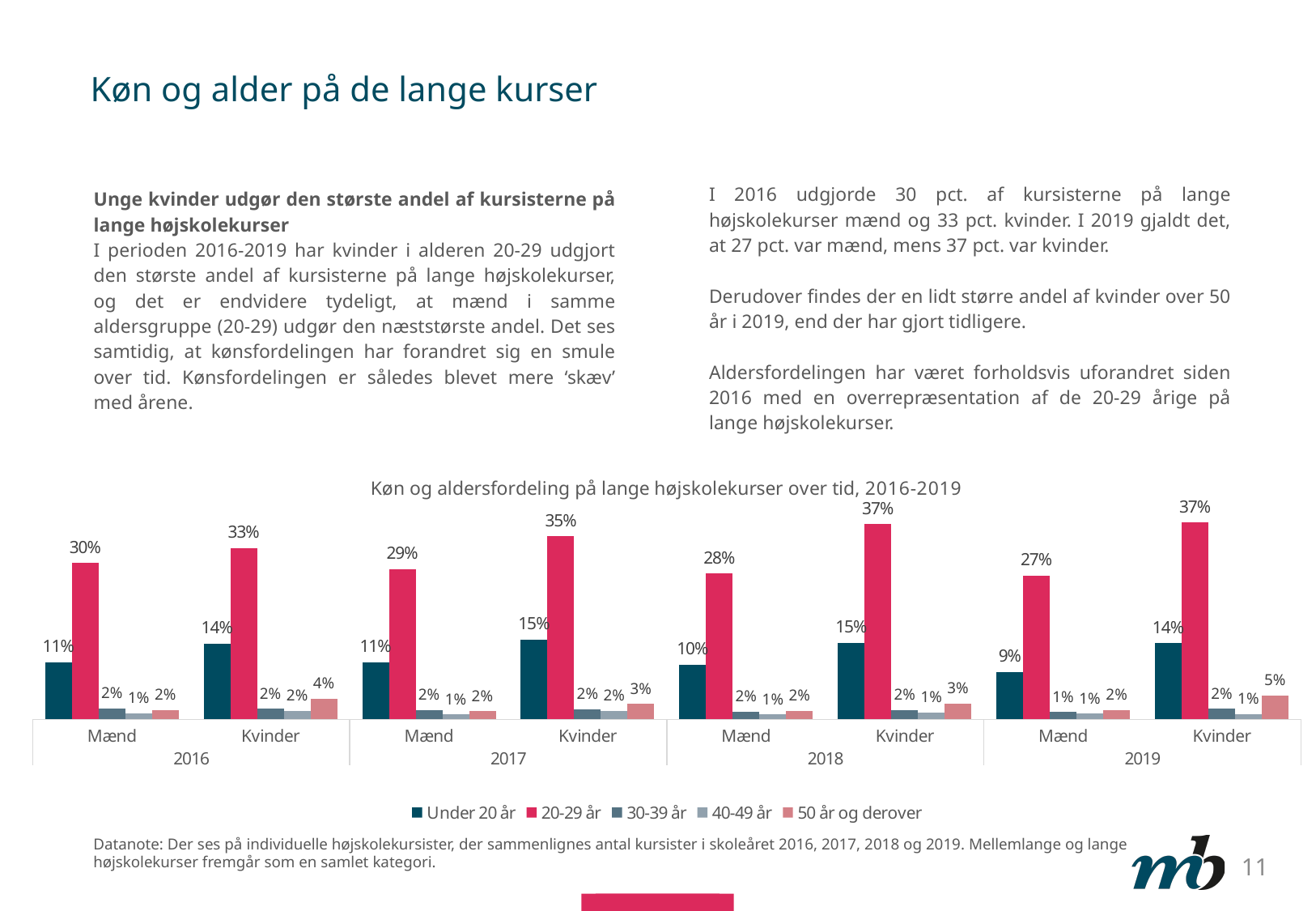
How many gender-year groups are shown on the x axis? 8 What is the value for 20-29 år among Kvinder in 2019? 37% How does the 20-29 år value for Mænd change from 2016 to 2019? It falls In which year and gender group does the 50 år og derover series reach its highest value? Kvinder 2019 What is the value for 50 år og derover among Kvinder in 2016? 4% How many series does the legend list? 5 What is the title of the chart? Køn og aldersfordeling på lange højskolekurser over tid, 2016-2019 What type of chart is shown on the slide? Bar chart What is the value for Under 20 år among Mænd in 2018? 10% Which age group has the highest value for Mænd in 2016? 20-29 år Which is larger: the Under 20 år value for Kvinder in 2017 or for Mænd in 2017? Kvinder in 2017 What is the difference between the 20-29 år value for Kvinder in 2019 and for Mænd in 2019? 10 percentage points